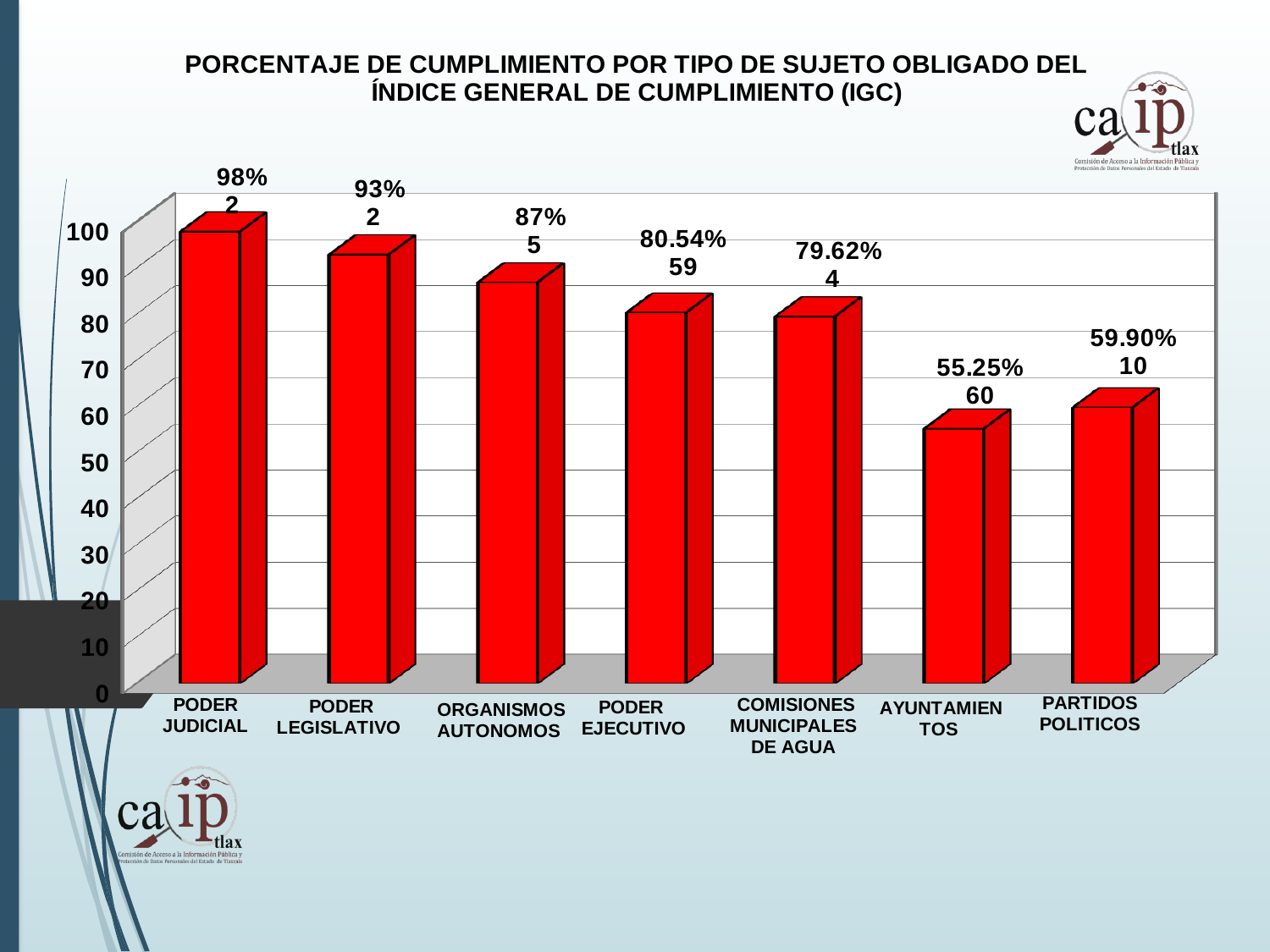
What is the difference in percentage points between PODER JUDICIAL and PODER LEGISLATIVO? 5 What is the compliance percentage shown for AYUNTAMIENTOS? 55.25% How many categories of obligated subjects are shown in the chart? 7 What kind of chart is shown on the slide? Bar chart What is the compliance percentage shown for PARTIDOS POLITICOS? 59.90% Which category has the highest compliance percentage? PODER JUDICIAL Which category has the lowest compliance percentage? AYUNTAMIENTOS Which has a higher compliance percentage, PODER EJECUTIVO or COMISIONES MUNICIPALES DE AGUA? PODER EJECUTIVO What number is printed below the 87% label for ORGANISMOS AUTONOMOS? 5 What is the compliance percentage shown for PODER EJECUTIVO? 80.54% What is the compliance percentage shown for PODER JUDICIAL? 98% What colour are the bars in the chart? Red